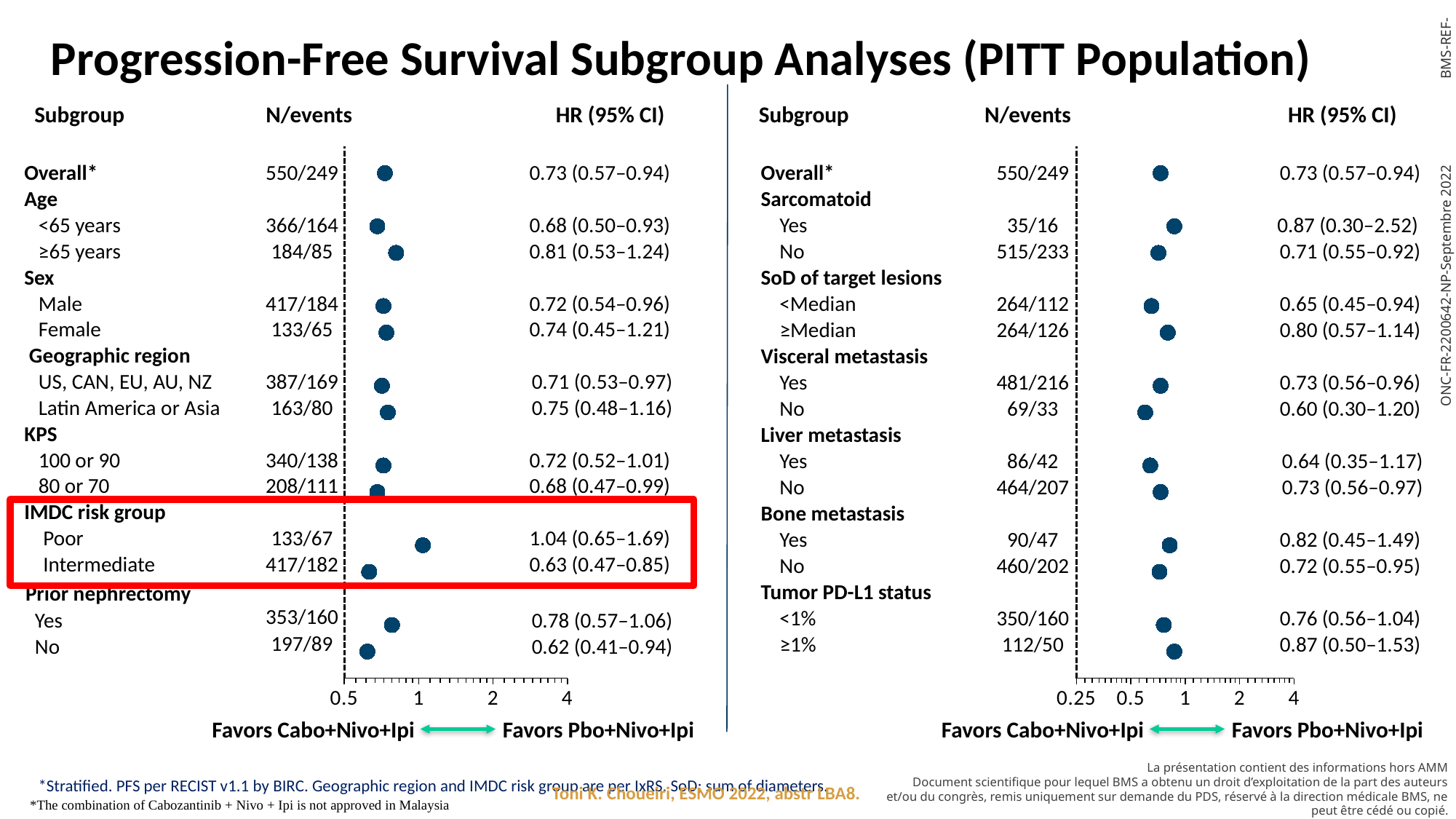
In the left chart, is the HR point for the IMDC Poor subgroup greater or less than 1? greater In the right chart, which subgroup has the lowest hazard ratio point estimate? Visceral metastasis No In the left chart, which subgroup has the lowest hazard ratio point estimate? Prior nephrectomy No What are the two labels at the ends of the arrow below each chart? Favors Cabo+Nivo+Ipi and Favors Pbo+Nivo+Ipi In the right chart, what is the HR (95% CI) for Visceral metastasis No? 0.60 (0.30–1.20) In the left chart, what is the hazard ratio (95% CI) for the Overall subgroup? 0.73 (0.57–0.94) What kind of chart is shown on the slide? Forest plot In the left chart, which subgroup has the highest hazard ratio point estimate? IMDC risk group Poor In the left chart, what is the difference between the HR point estimates for IMDC Poor and IMDC Intermediate? 0.41 In the right chart, what is the N/events value for the Sarcomatoid Yes subgroup? 35/16 In the right chart, which has the larger HR point estimate: Liver metastasis Yes or Liver metastasis No? Liver metastasis No In the left chart, what is the HR (95% CI) for the IMDC Poor risk group? 1.04 (0.65–1.69)